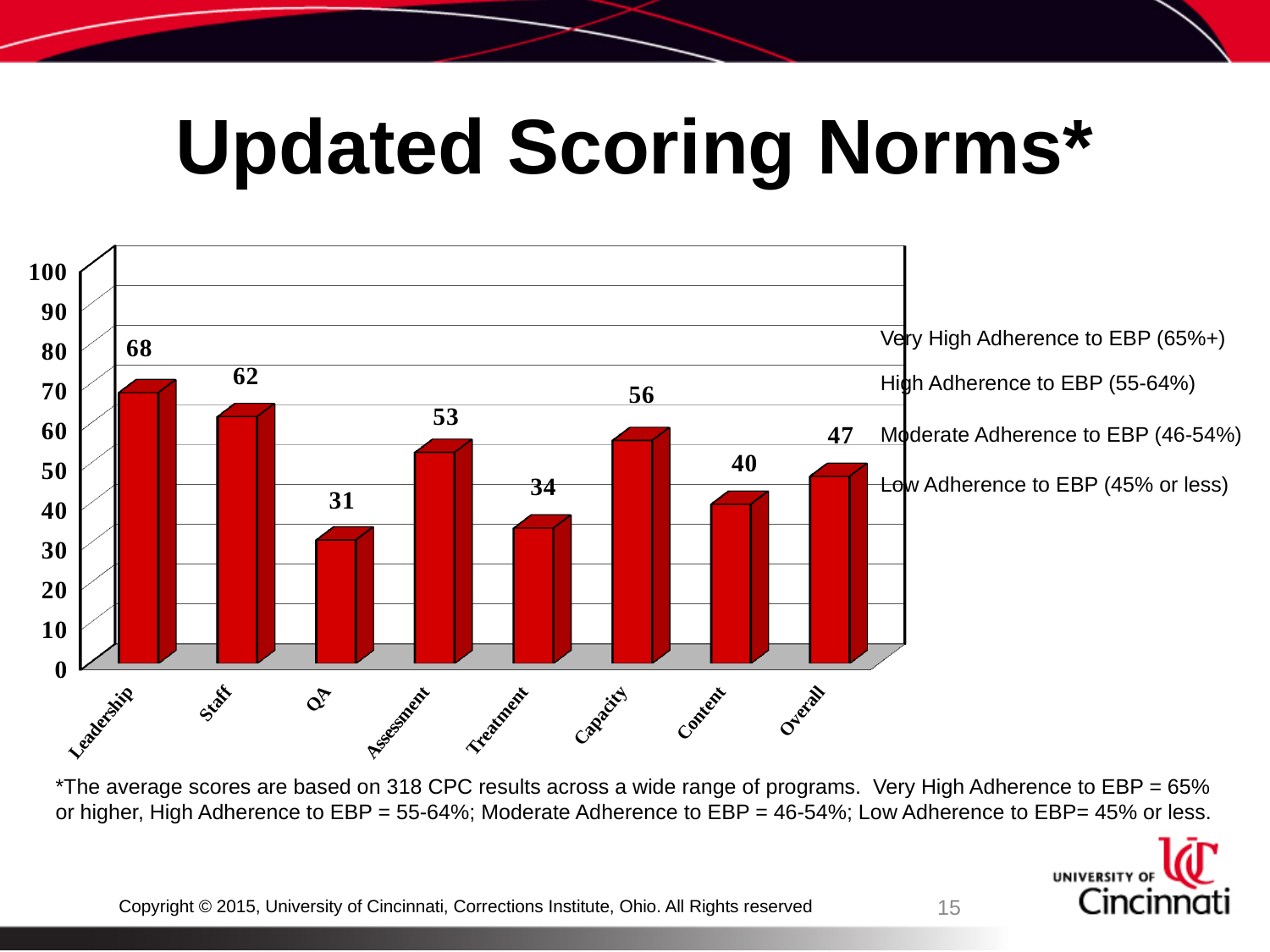
What is the value for Leadership? 68 What kind of chart is shown on the slide? bar chart Which is larger, the value for Capacity or the value for Assessment? Capacity What is the difference between the values for Staff and Content? 22 Which category has the highest value? Leadership What is the value for QA? 31 What is the difference between the values for Leadership and QA? 37 What is the title of the slide containing the chart? Updated Scoring Norms* Which category has the lowest value? QA Is the value for Treatment greater or less than 40? less How many categories are shown on the x axis? 8 What is the value for Overall? 47